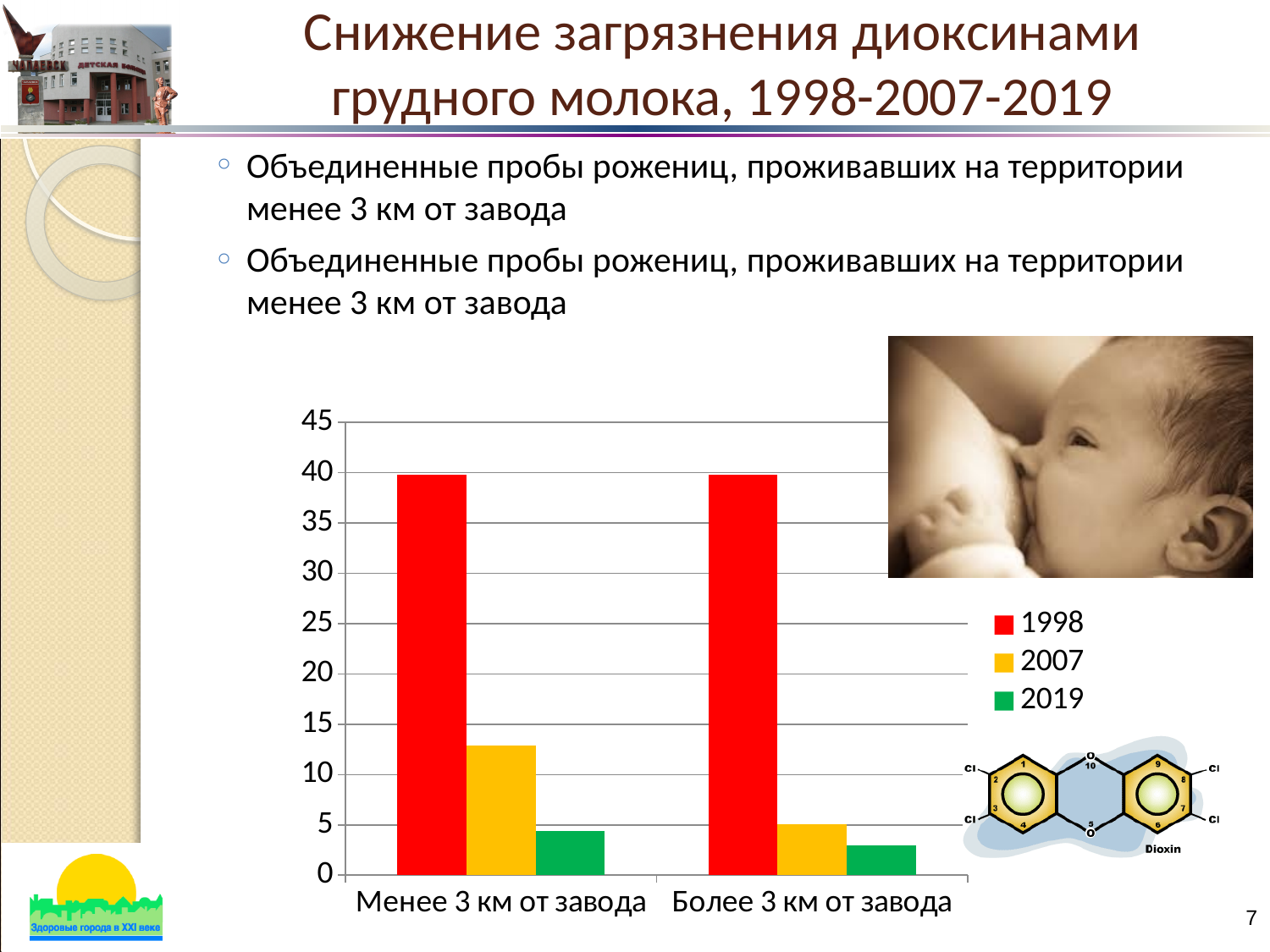
How many categories are shown on the x axis of the chart? 2 Is the 2007 value for "Более 3 км от завода" greater or less than 10? less How many series does the chart legend list? 3 What kind of chart is shown on the slide? bar chart Which series has the highest value for the category "Менее 3 км от завода"? 1998 Is the 1998 value for "Менее 3 км от завода" greater or less than 35? greater For the category "Менее 3 км от завода", do the values rise or fall from 1998 to 2019? fall Which colour represents the 2007 series in the chart legend? yellow Which is larger: the 2007 value for "Менее 3 км от завода" or the 2007 value for "Более 3 км от завода"? Менее 3 км от завода Which series has the lowest value for the category "Более 3 км от завода"? 2019 Is the 2019 value for "Более 3 км от завода" greater or less than 5? less